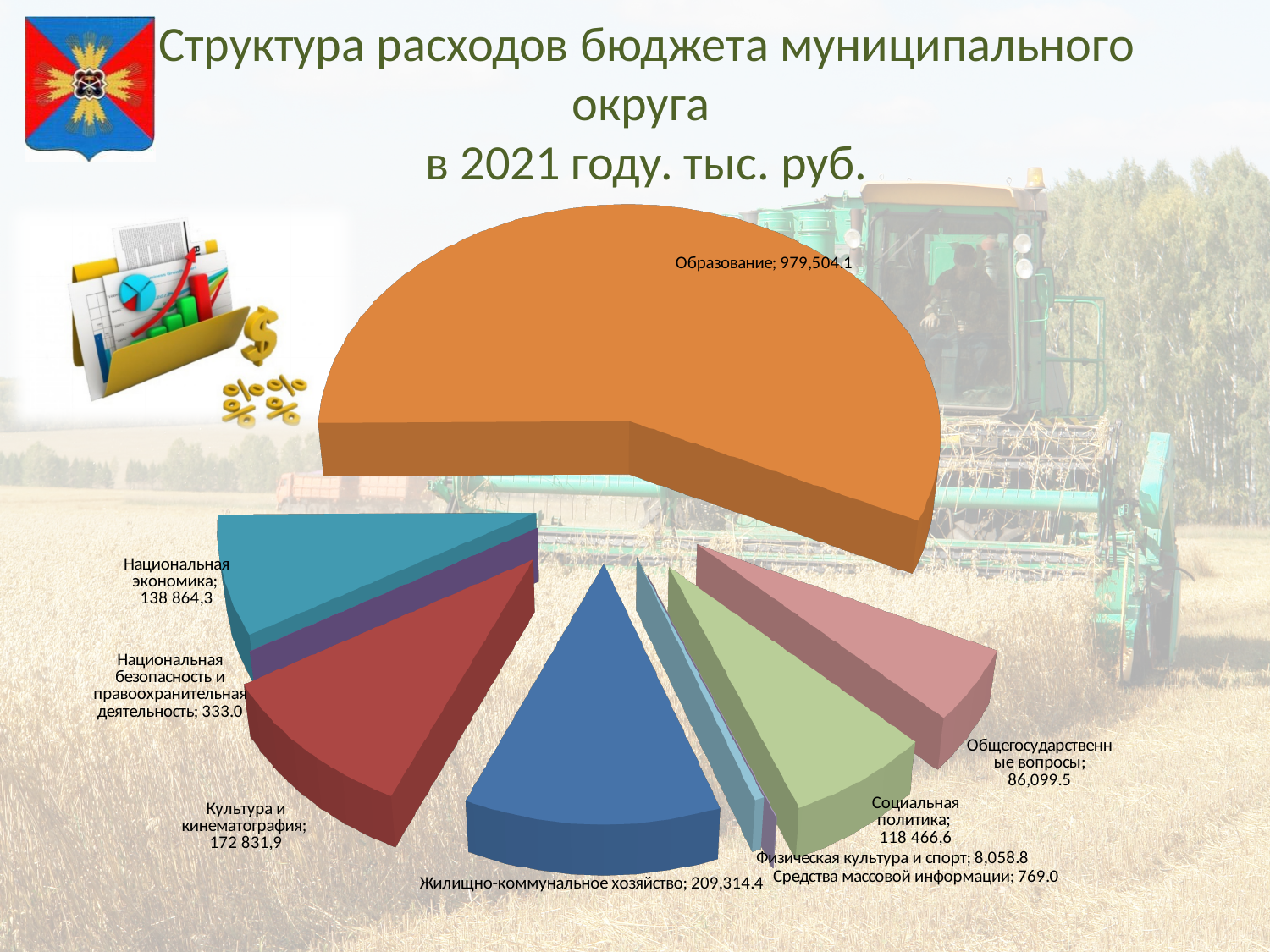
What is the value for Социальная политика? 118 466,6 What is the difference between Национальная экономика and Социальная политика? 20 397,7 What is the value for Средства массовой информации? 769.0 Which category has the largest share of the pie? Образование What is the value for Культура и кинематография? 172 831,9 What is the value for Образование? 979,504.1 Which is larger: Жилищно-коммунальное хозяйство or Культура и кинематография? Жилищно-коммунальное хозяйство What is the value for Жилищно-коммунальное хозяйство? 209,314.4 Which category has the smallest value? Национальная безопасность и правоохранительная деятельность What kind of chart is shown on the slide? pie chart How many categories does the pie chart show? 9 In what units are the values on the chart given, according to the title? тыс. руб.